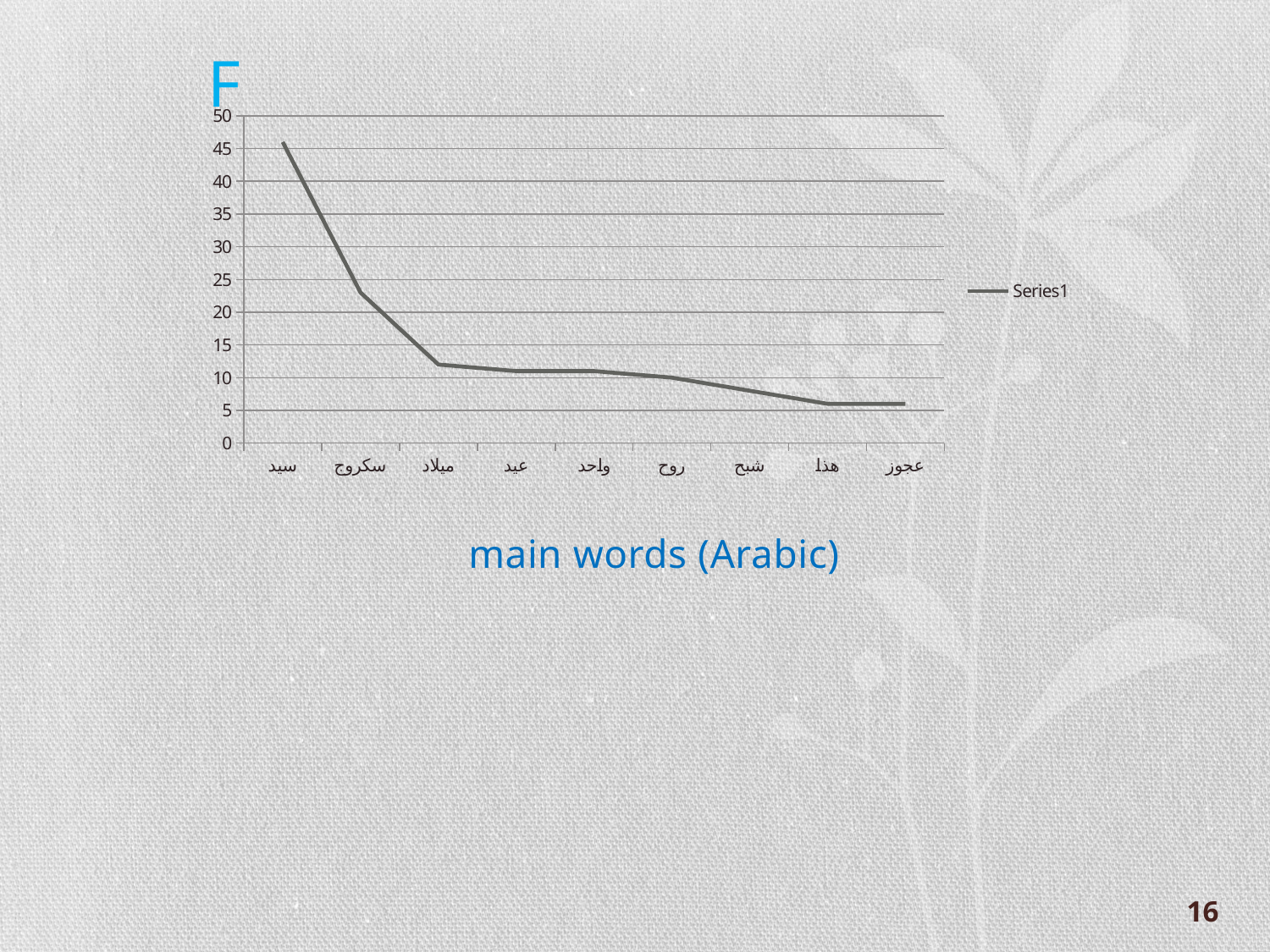
What is the title shown above the chart? F Is the value for سيد greater or less than 40? greater Do the values rise or fall moving from left to right along the x axis? fall Is the value for ميلاد greater or less than 15? less How many categories are plotted along the x axis? 9 What is the legend entry for the plotted series? Series1 Is the value for عجوز greater or less than 10? less What kind of chart is shown on the slide? line chart Which category has the highest value? سيد Which has the larger value, سيد or سكروج? سيد How many series does the legend list? 1